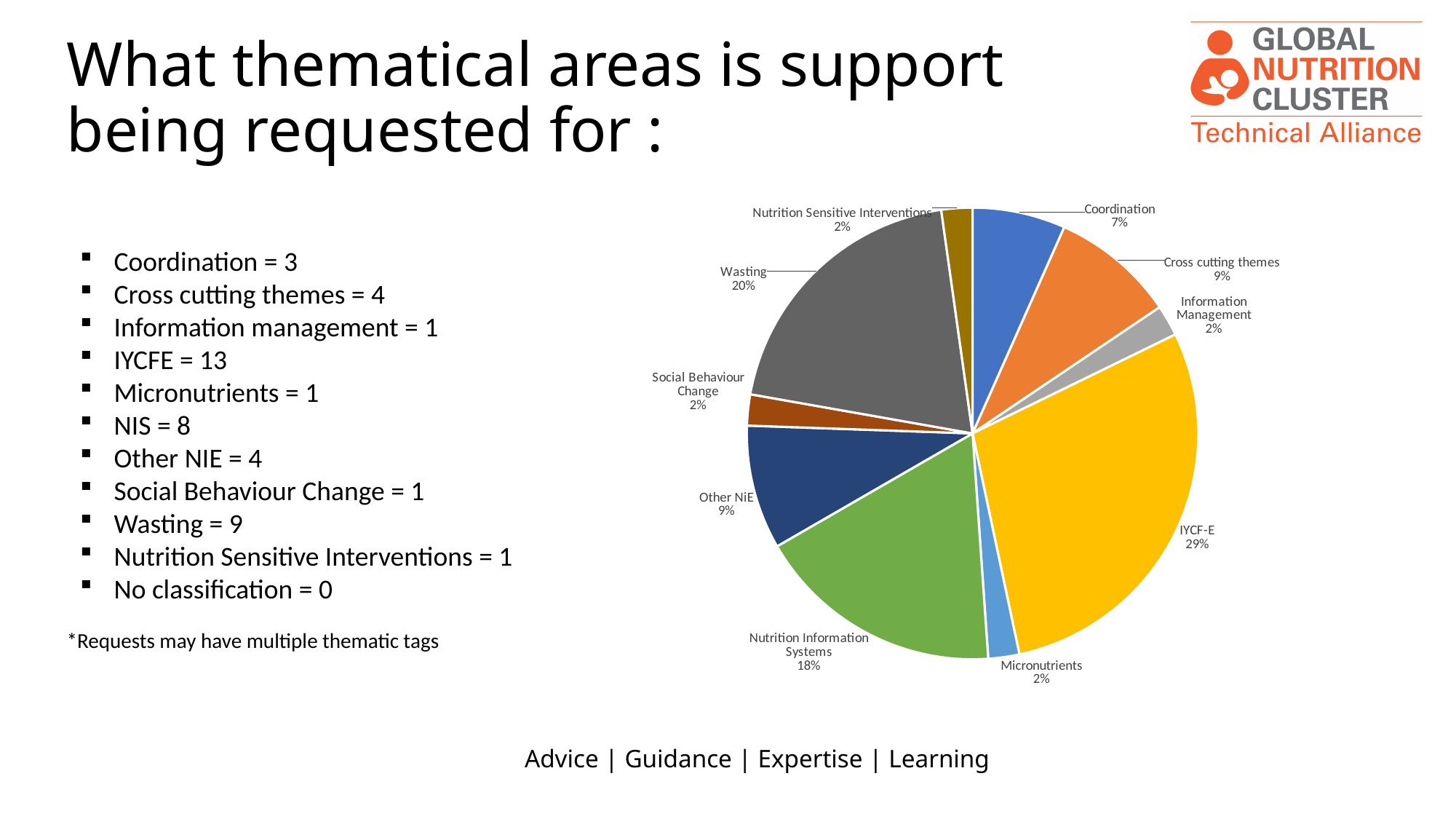
Which slice of the pie chart is the largest? IYCF-E What percentage is shown for Wasting? 20% What percentage is shown for Coordination? 7% What colour is the IYCF-E slice of the pie chart? Yellow What type of chart is shown on the slide? Pie chart How many slices does the pie chart have? 10 What is the difference in percentage points between Wasting and Nutrition Information Systems? 2 What percentage is shown for Other NiE? 9% What is the difference in percentage points between IYCF-E and Wasting? 9 What share of the pie does IYCF-E represent? 29% Which is larger, the share for Cross cutting themes or the share for Coordination? Cross cutting themes What percentage is shown for Nutrition Information Systems? 18%